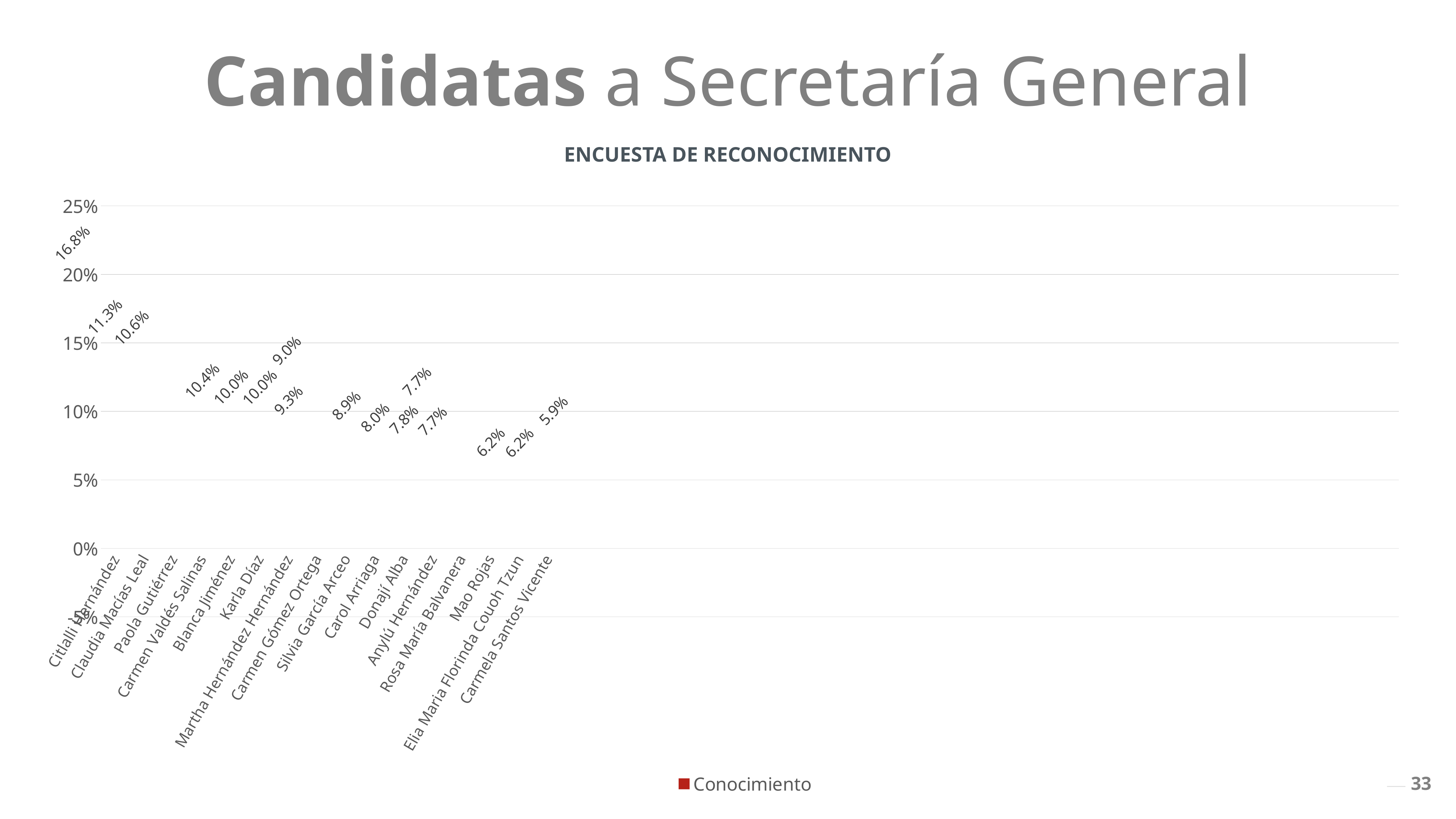
Which candidate has the highest value? Citlalli Hernández How many series does the legend list? 1 What is the difference between the values for Citlalli Hernández and Claudia Macías Leal? 5.5% Which candidate has the lowest value? Carmela Santos Vicente How many candidates are shown on the x axis? 16 What is the value for Claudia Macías Leal? 11.3% What is the value for Citlalli Hernández? 16.8% What is the value for Paola Gutiérrez? 10.6% What is the title of the chart? ENCUESTA DE RECONOCIMIENTO What is the value for Carmela Santos Vicente? 5.9% What series does the legend list? Conocimiento What kind of chart is shown on the slide? bar chart